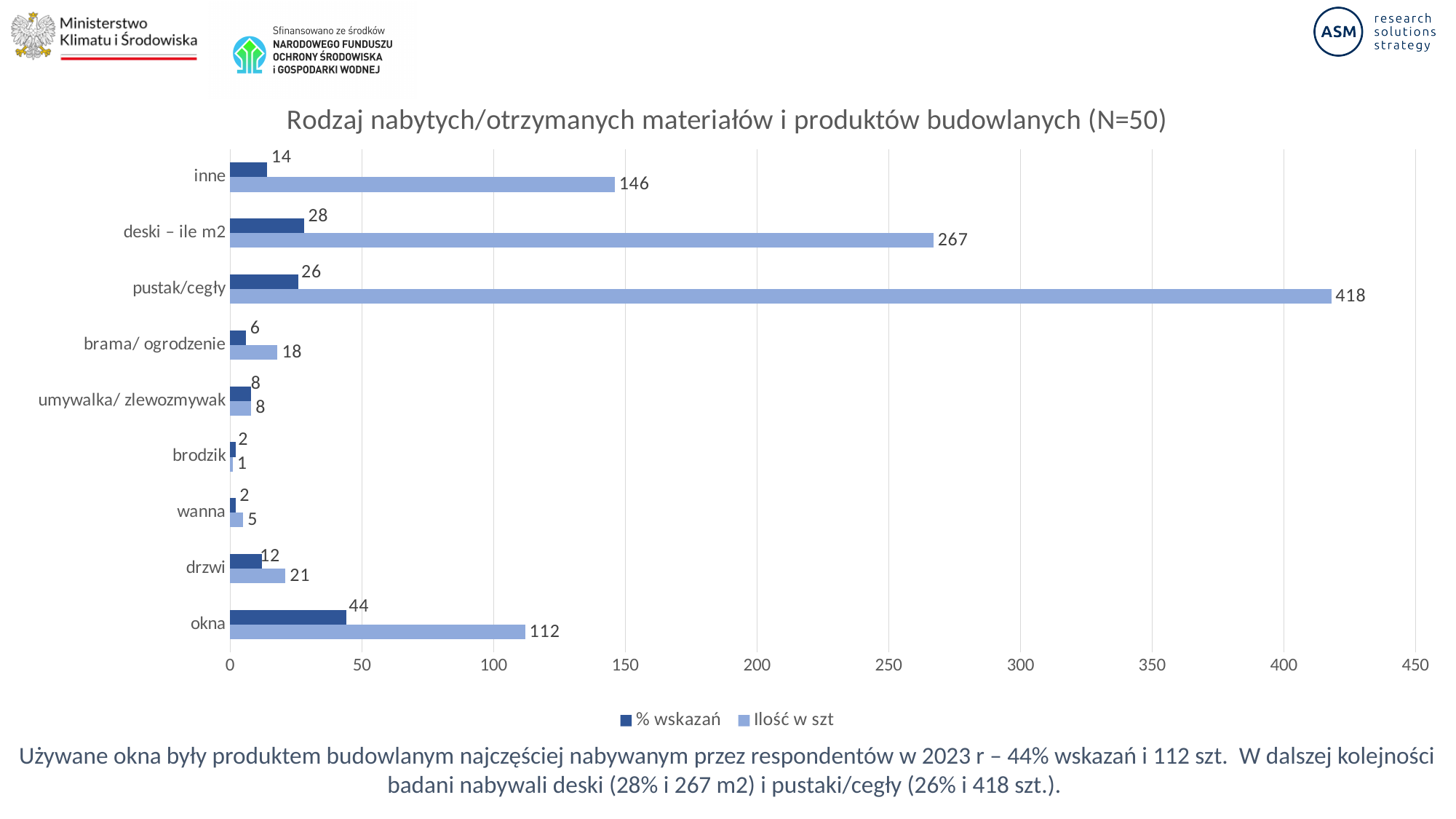
What is the title of the chart? Rodzaj nabytych/otrzymanych materiałów i produktów budowlanych (N=50) What kind of chart is shown on the slide? bar chart Which category has the highest '% wskazań' value? okna Which category has the highest 'Ilość w szt' value? pustak/cegły What is the 'Ilość w szt' value for pustak/cegły? 418 How many series does the legend list? 2 Which is larger: the 'Ilość w szt' value for inne or for okna? inne What is the 'Ilość w szt' value for deski – ile m2? 267 What is the difference between the 'Ilość w szt' values for pustak/cegły and deski – ile m2? 151 What is the '% wskazań' value for okna? 44 Which category has the lowest 'Ilość w szt' value? brodzik How many categories are shown on the chart? 9